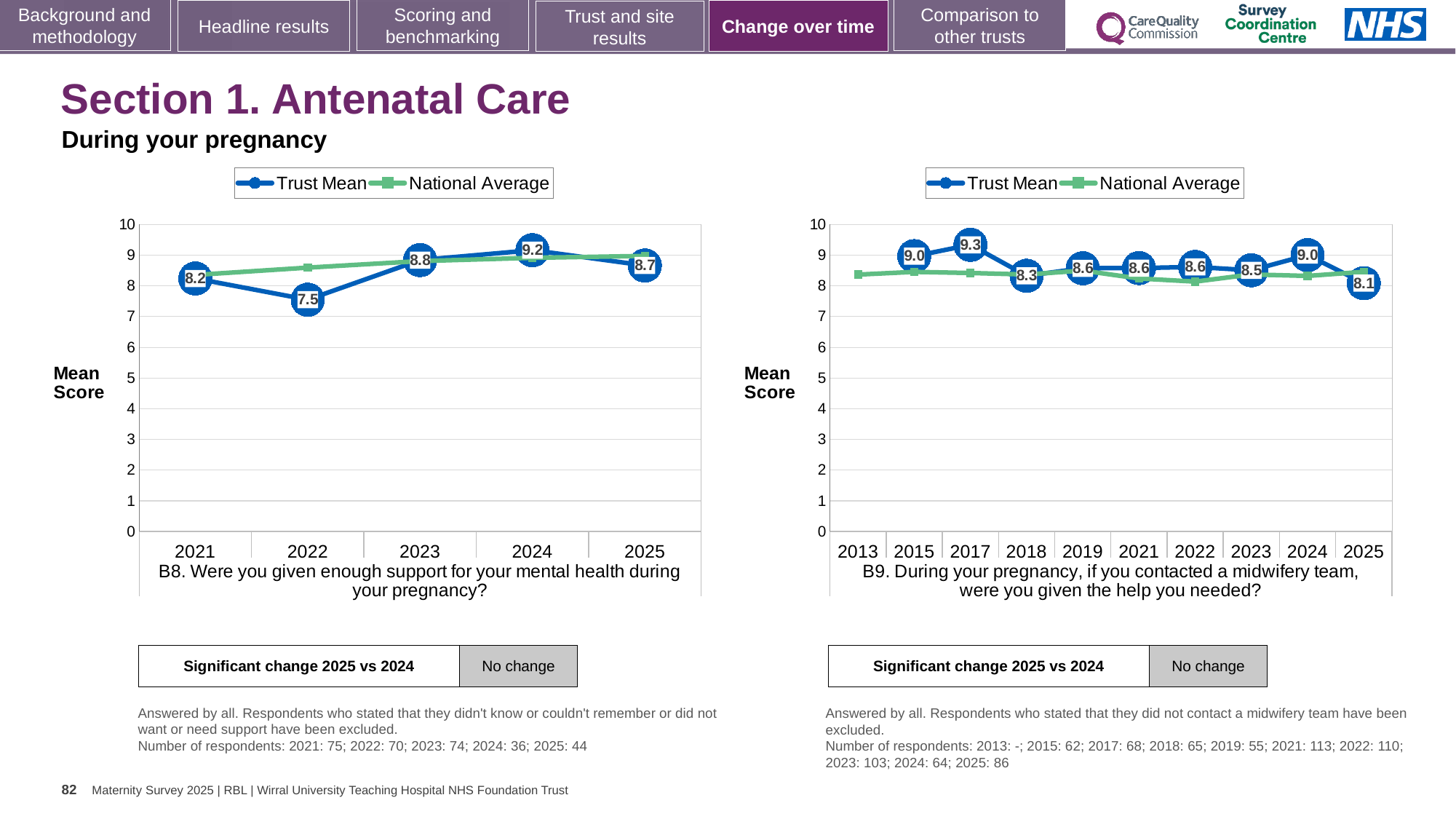
In the right chart (B9), which year has the highest Trust Mean? 2017 In the left chart (B8), what is the Trust Mean for 2022? 7.5 In the left chart (B8), how many years are shown on the x axis? 5 In the right chart (B9), what is the Trust Mean for 2025? 8.1 In the right chart (B9), what is the Trust Mean for 2017? 9.3 In the right chart (B9), what is the difference between the Trust Mean in 2017 and in 2025? 1.2 In the left chart (B8), which year has the lowest Trust Mean? 2022 What type of chart is the left chart (B8)? Line chart In the right chart (B9), how many series does the legend list? 2 In the right chart (B9), is the Trust Mean higher in 2024 or in 2025? 2024 In the left chart (B8), what is the Trust Mean for 2024? 9.2 In the left chart (B8), what is the difference between the Trust Mean in 2024 and in 2022? 1.7